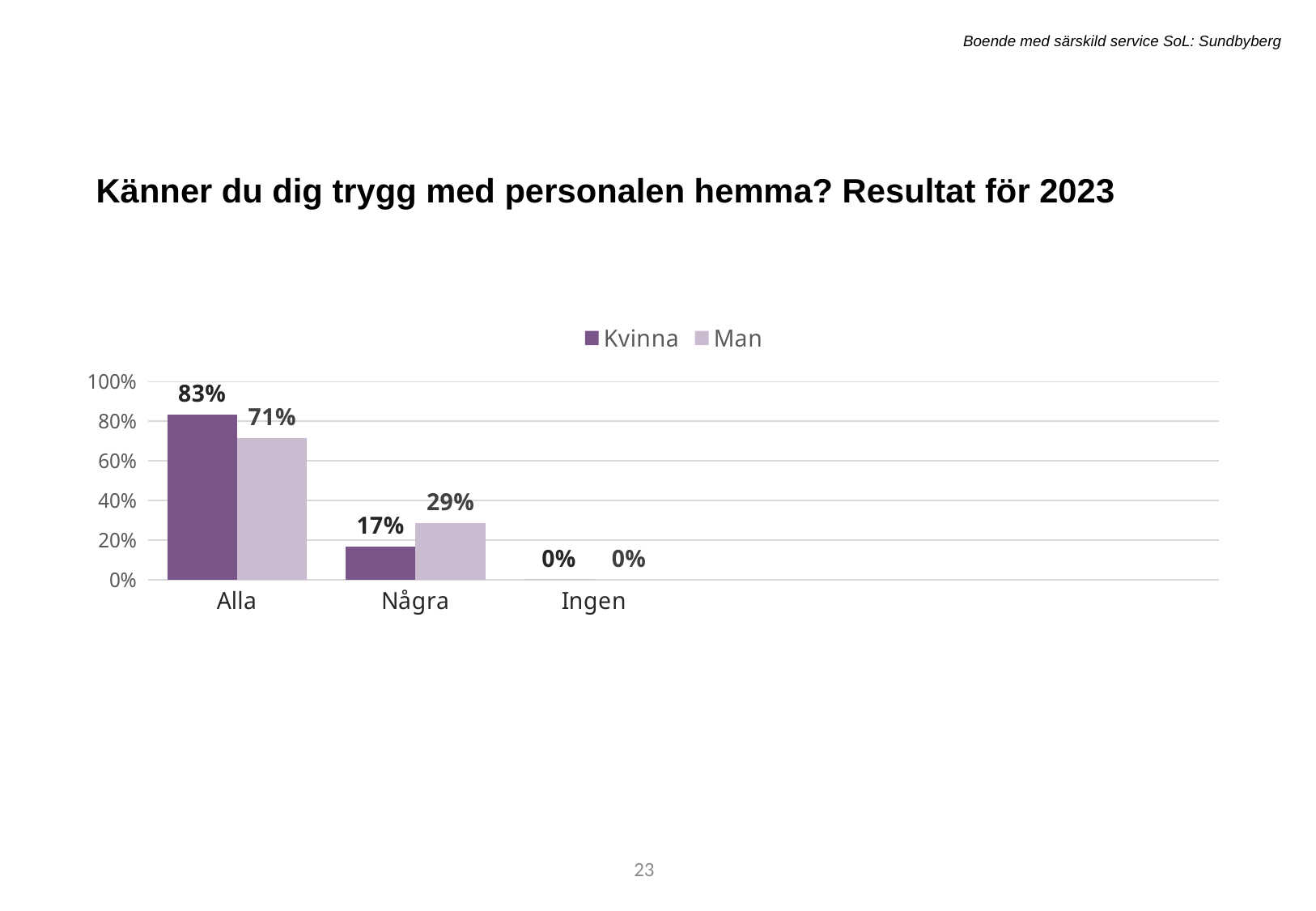
What is the value for Kvinna in the Ingen category? 0% In the Några category, which series has the larger value, Kvinna or Man? Man Which category has the highest value for the Kvinna series? Alla How many series does the legend list? 2 What is the value for Kvinna in the Några category? 17% What is the value for Man in the Alla category? 71% What is the value for Kvinna in the Alla category? 83% What is the value for Man in the Några category? 29% What is the difference between the Kvinna and Man values in the Alla category? 12% Which category has the lowest value for the Man series? Ingen What kind of chart is shown on the slide? Bar chart How many categories are shown on the x axis? 3